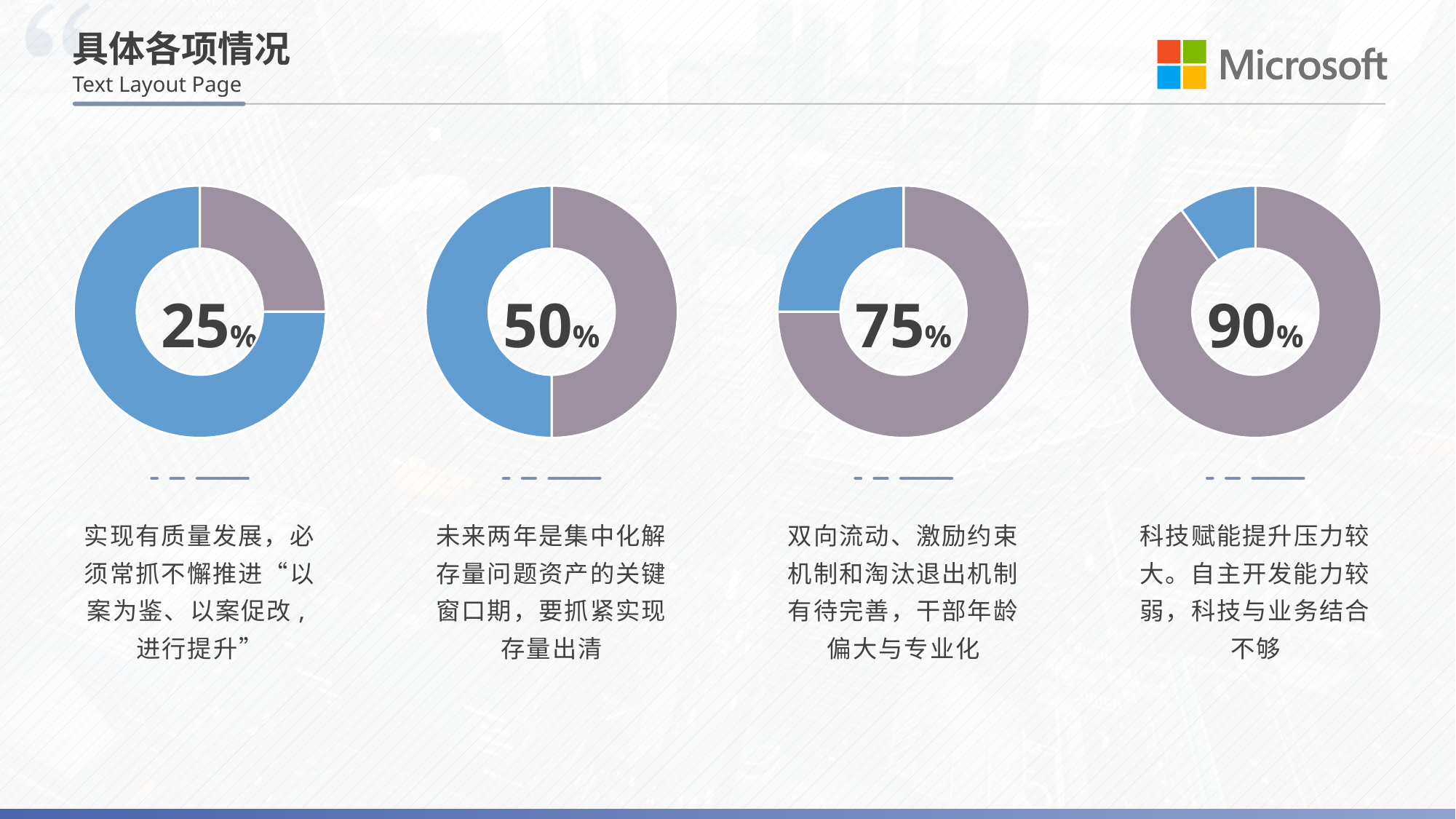
In the rightmost donut chart, what share of the ring does the grey-purple slice take up? 90% Which is larger: the percentage in the second donut chart or the percentage in the third donut chart? The third donut chart (75%) Do the percentages in the donut charts increase or decrease from left to right across the slide? Increase What is the difference between the percentage in the rightmost donut chart and the percentage in the leftmost donut chart? 65% What percentage is shown in the centre of the third donut chart from the left? 75% Which donut chart shows the lowest percentage? The leftmost one (25%) What percentage is shown in the centre of the rightmost donut chart? 90% What kind of chart is used for each of the four figures on the slide? Donut chart What percentage is shown in the centre of the second donut chart from the left? 50% Which donut chart shows the highest percentage? The rightmost one (90%) How many donut charts are on the slide? 4 What percentage is shown in the centre of the leftmost donut chart? 25%